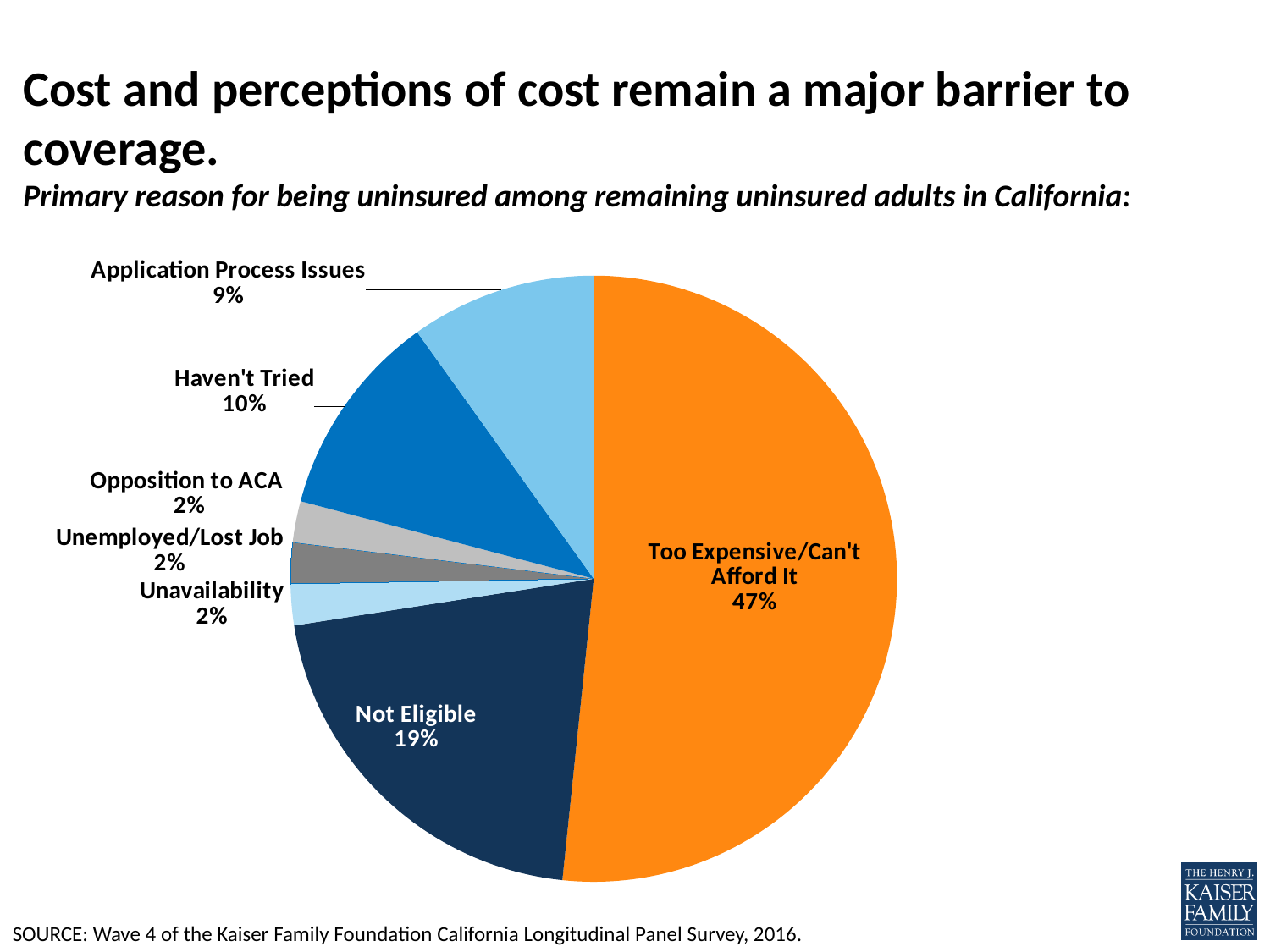
What kind of chart is shown on the slide? pie chart What is the subtitle of the chart, describing what the pie shows? Primary reason for being uninsured among remaining uninsured adults in California: Which reason has the largest slice of the pie? Too Expensive/Can't Afford It What share of remaining uninsured adults cite "Too Expensive/Can't Afford It" as their primary reason? 47% How many slices does the pie chart have? 7 What percentage is shown for "Opposition to ACA"? 2% What percentage is shown for "Not Eligible"? 19% What percentage is shown for "Application Process Issues"? 9% What is the difference in percentage points between "Too Expensive/Can't Afford It" and "Not Eligible"? 28 What is the combined share of "Not Eligible" and "Haven't Tried"? 29% What percentage is shown for "Haven't Tried"? 10% Which is larger, the share for "Haven't Tried" or the share for "Application Process Issues"? Haven't Tried